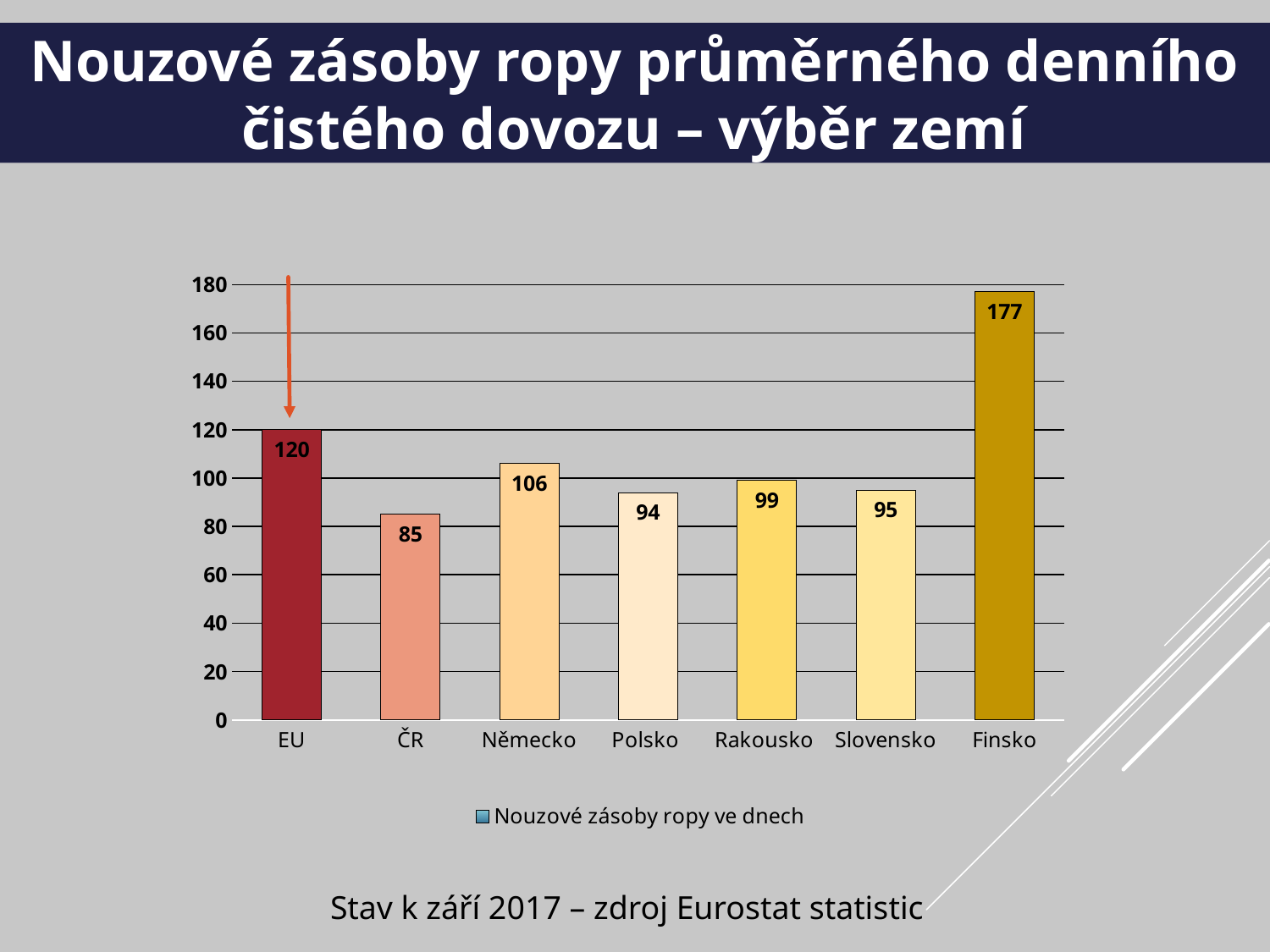
Is the value for EU greater or less than 100? greater What is the difference between the values for Rakousko and Polsko? 5 What series name does the legend show? Nouzové zásoby ropy ve dnech What is the value for ČR? 85 Which is larger, the value for Slovensko or the value for Polsko? Slovensko What is the value for Německo? 106 Which category has the highest value? Finsko What is the difference between the values for Finsko and EU? 57 How many categories are shown on the x axis? 7 Which category has the lowest value? ČR What kind of chart is shown on the slide? bar chart What is the value for Finsko? 177